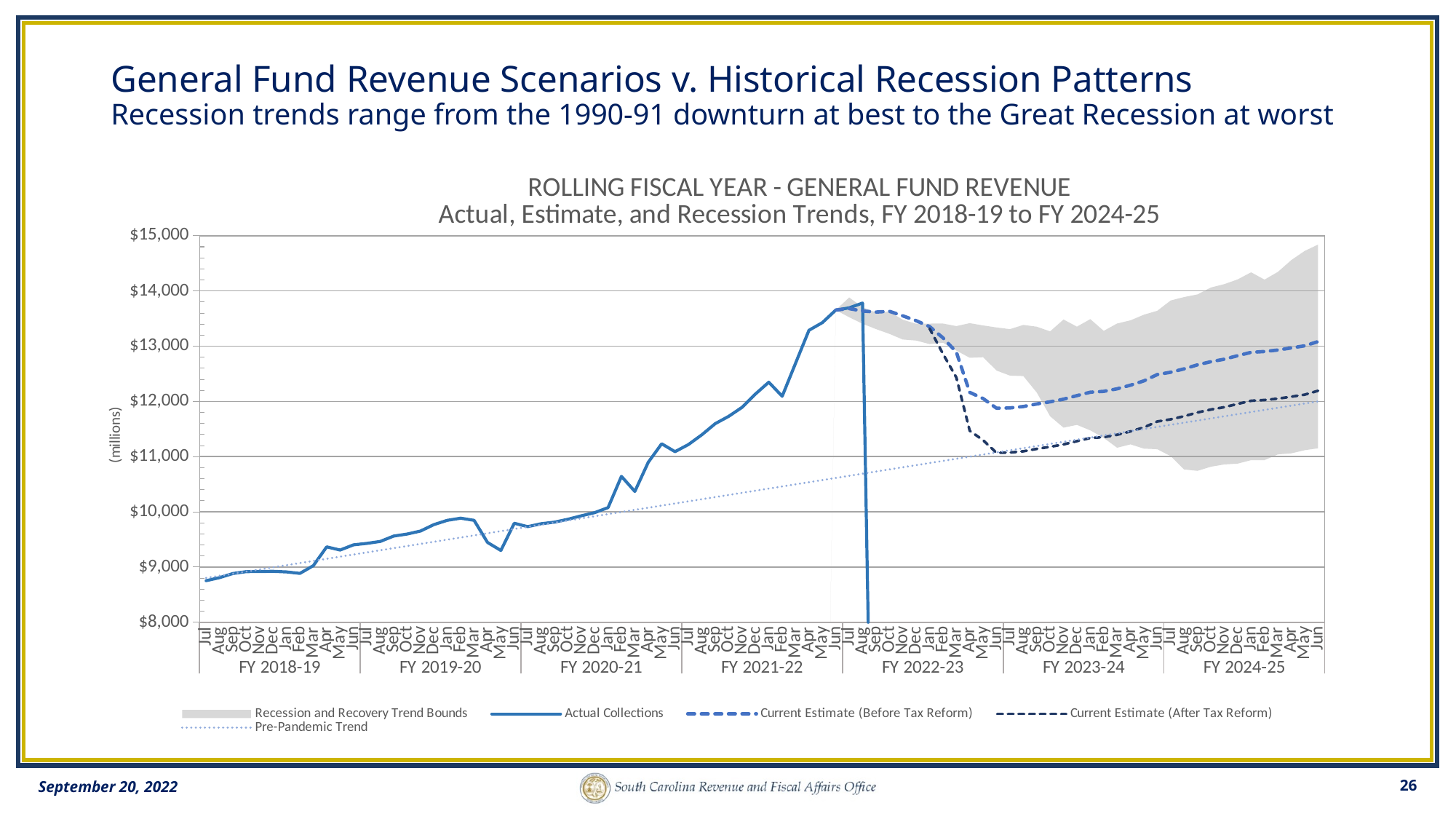
How many fiscal years are labelled along the x axis of the chart? 7 What is the title of the chart? ROLLING FISCAL YEAR - GENERAL FUND REVENUE Actual, Estimate, and Recession Trends, FY 2018-19 to FY 2024-25 How many series does the chart legend list? 5 What does the grey shaded area on the chart represent, according to the legend? Recession and Recovery Trend Bounds Is the value of Actual Collections in Jun of FY 2021-22 greater or less than $13,000? greater In Jun of FY 2024-25, which is higher: the Current Estimate (Before Tax Reform) or the Current Estimate (After Tax Reform)? Current Estimate (Before Tax Reform) What kind of chart is shown on the slide? Line chart What unit is shown on the y axis of the chart? millions Is the Current Estimate (After Tax Reform) in Jun of FY 2024-25 greater or less than $12,000? greater Is the Current Estimate (Before Tax Reform) in Jun of FY 2022-23 greater or less than $12,000? less Do Actual Collections generally rise or fall from Jul of FY 2018-19 to Jun of FY 2021-22? rise